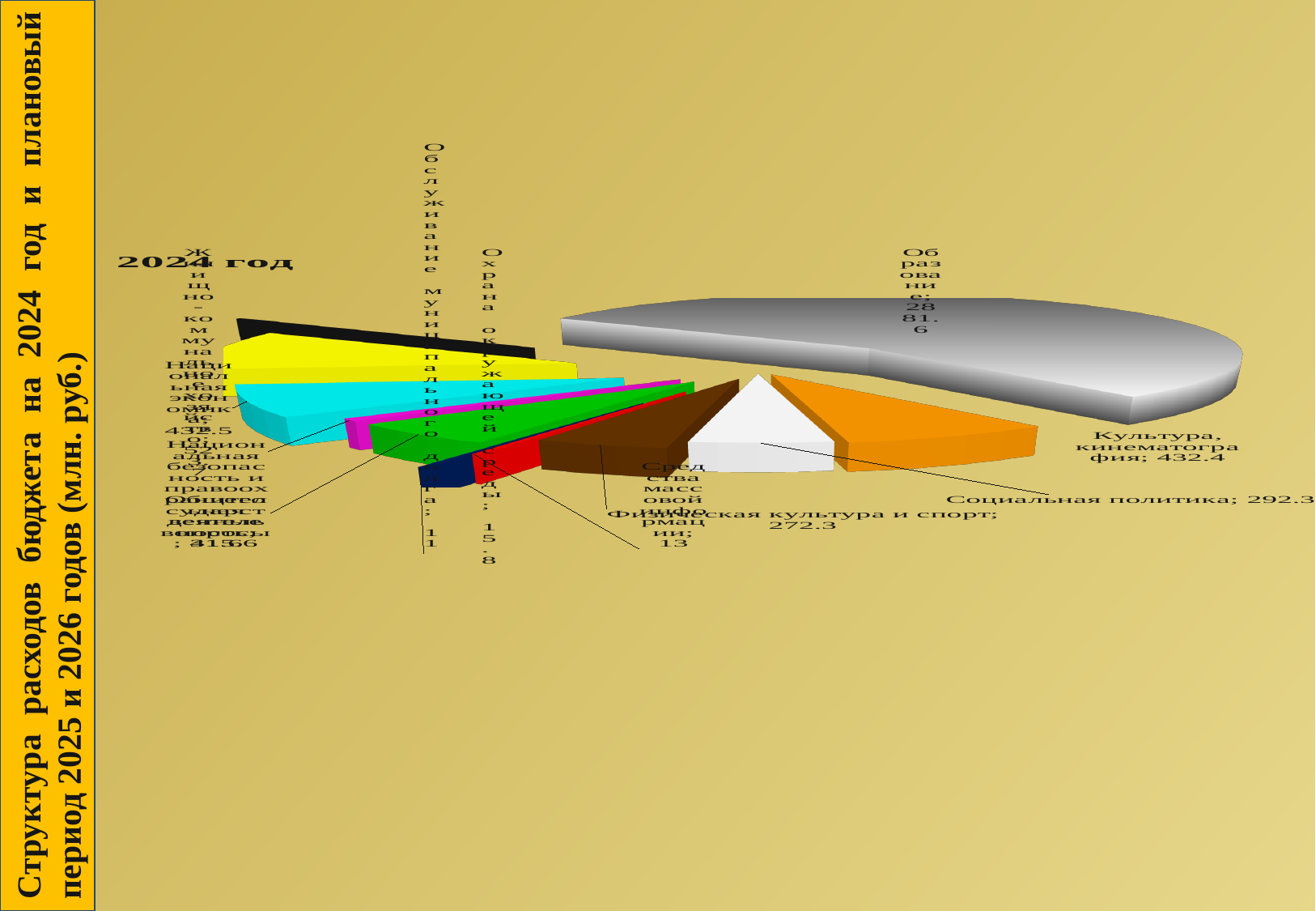
What is the value for Физическая культура и спорт? 272.3 What is the title of the pie chart? 2024 год What is the difference between Культура, кинематография and Социальная политика? 140.1 What is the value for Охрана окружающей среды? 15.8 What kind of chart is shown on the slide? pie chart Which is larger: Культура, кинематография or Социальная политика? Культура, кинематография What is the value for Обслуживание муниципального долга? 11 What is the value for Социальная политика? 292.3 What is the value for Средства массовой информации? 13 What is the value for Культура, кинематография? 432.4 What is the value for Образование in the pie chart? 2881.6 Which category has the largest slice in the pie chart? Образование